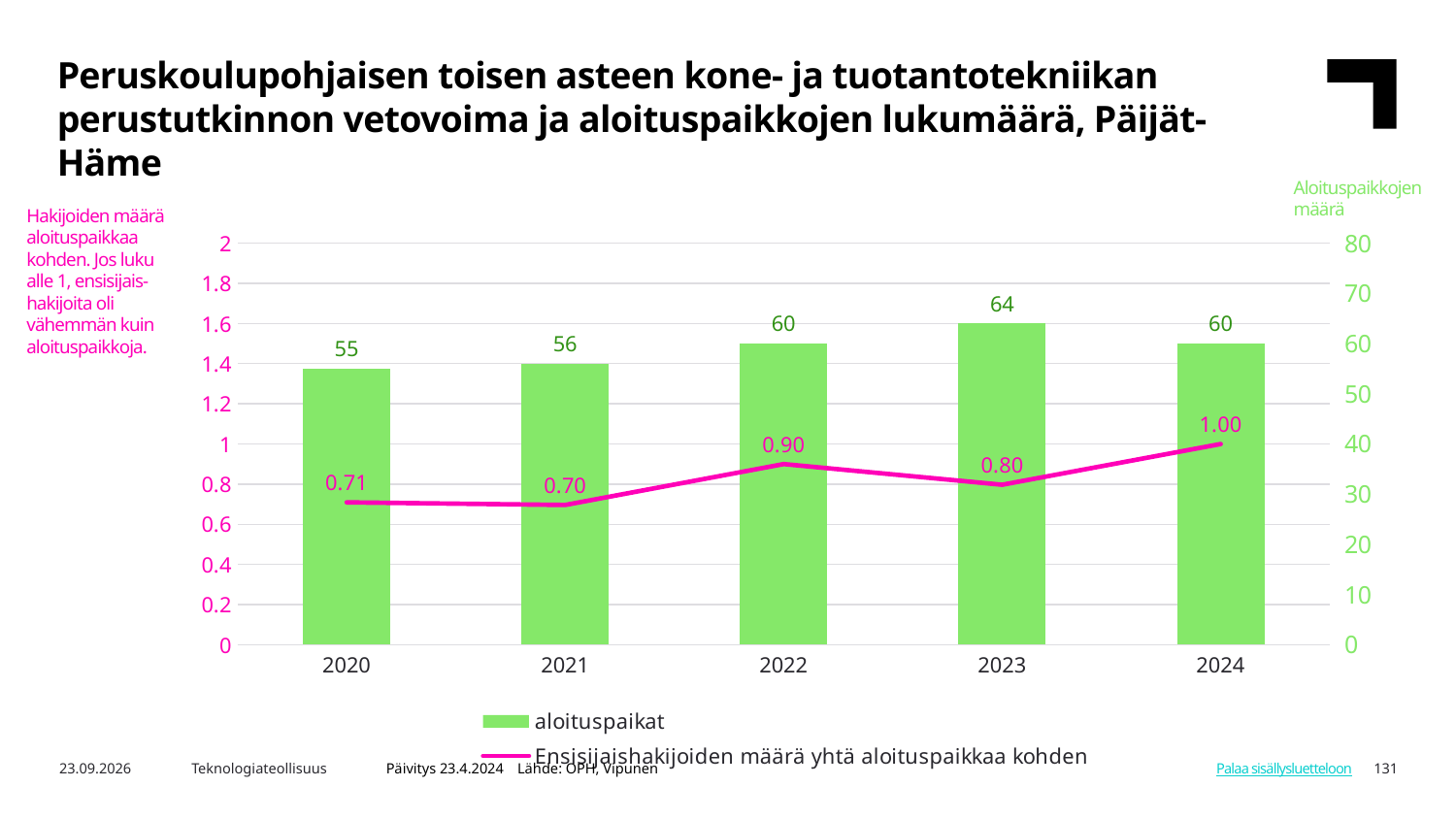
What is the value of aloituspaikat for 2023? 64 How many series does the legend list? 2 Which year has the highest value of aloituspaikat? 2023 Which is larger, the Ensisijaishakijoiden määrä yhtä aloituspaikkaa kohden value for 2022 or for 2023? 2022 What colour are the aloituspaikat bars? green Which year has the lowest value of Ensisijaishakijoiden määrä yhtä aloituspaikkaa kohden? 2021 What is the value of Ensisijaishakijoiden määrä yhtä aloituspaikkaa kohden for 2022? 0.90 What kind of chart is used for the aloituspaikat series? bar chart Does the Ensisijaishakijoiden määrä yhtä aloituspaikkaa kohden value rise or fall from 2023 to 2024? rise How many years are shown on the x axis? 5 What is the difference between the aloituspaikat values for 2023 and 2020? 9 What is the value of aloituspaikat for 2020? 55